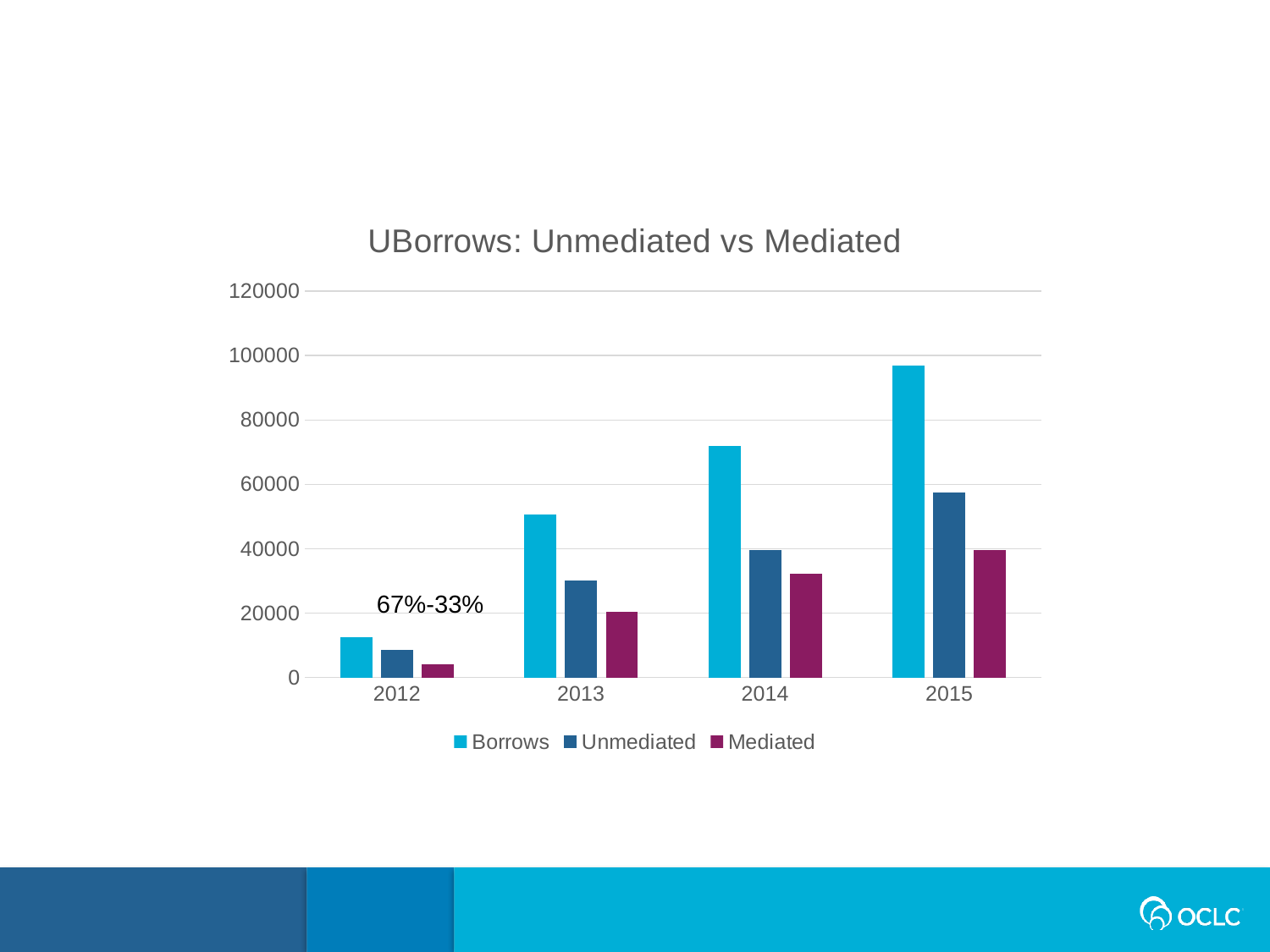
How many series does the legend list? 3 In 2015, which is larger: the Unmediated value or the Mediated value? Unmediated Is the Borrows value for 2014 greater or less than 60000? greater What type of chart is shown on the slide? bar chart Is the Unmediated value for 2013 greater or less than 20000? greater How many years are shown on the x axis? 4 What is the title of the chart? UBorrows: Unmediated vs Mediated In which year is the Mediated value lowest? 2012 Do the Borrows values rise or fall from 2012 to 2015? rise In which year is the Borrows value highest? 2015 Is the Borrows value for 2015 greater or less than 80000? greater